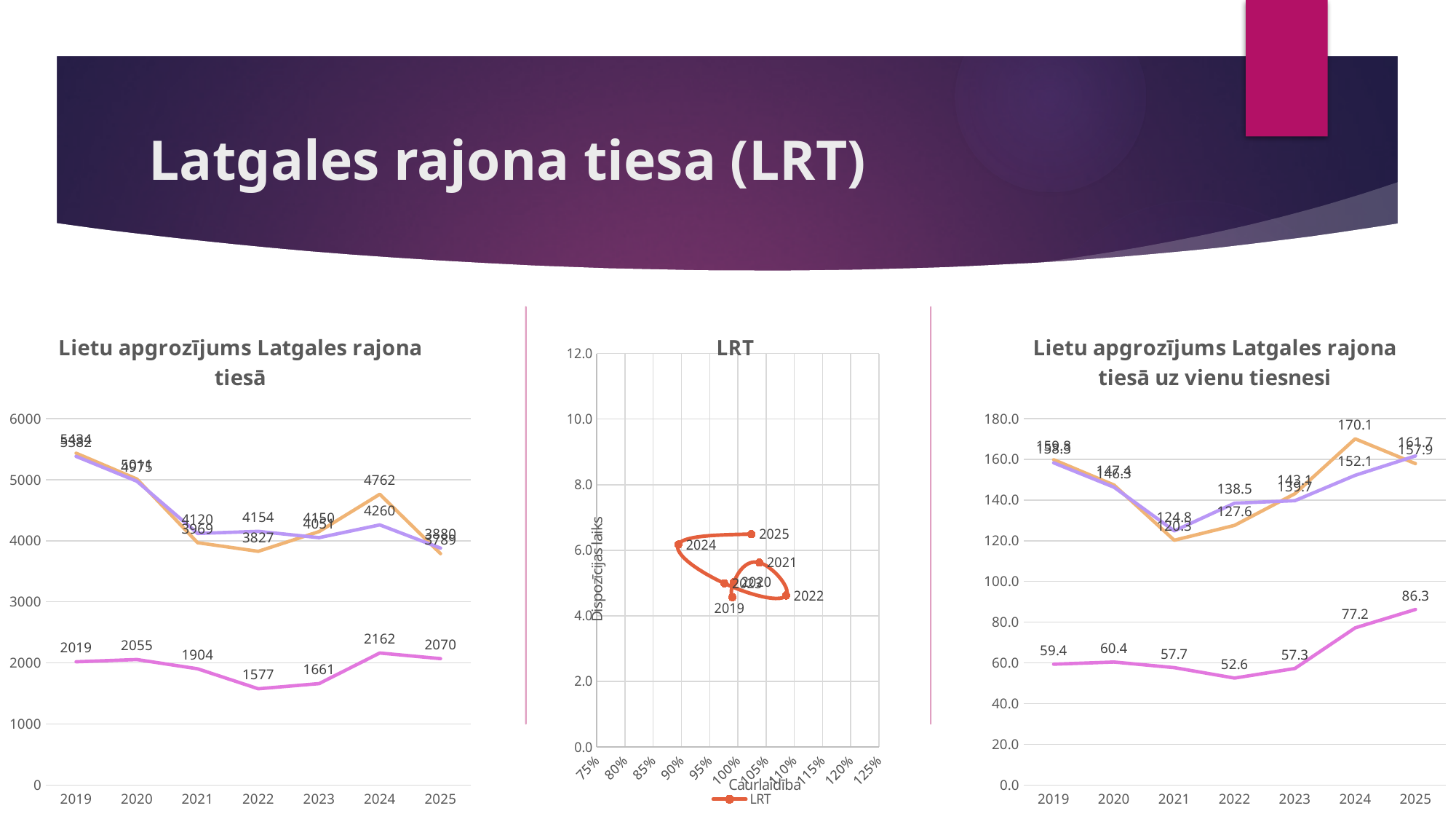
In the chart 'Lietu apgrozījums Latgales rajona tiesā uz vienu tiesnesi', what is the value of the pink (lowest) line in 2025? 86.3 In the chart 'Lietu apgrozījums Latgales rajona tiesā', in which year does the pink (lowest) line reach its lowest value? 2022 In the chart 'Lietu apgrozījums Latgales rajona tiesā uz vienu tiesnesi', does the pink (lowest) line rise or fall from 2023 to 2025? rise In the chart 'Lietu apgrozījums Latgales rajona tiesā', what is the value of the pink (lowest) line in 2022? 1577 How many series does the legend of the middle chart 'LRT' list? 1 What kind of chart is the middle chart titled 'LRT'? scatter chart In the middle chart 'LRT', is the Dispozīcijas laiks value for the 2025 point greater or less than 6.0? greater What is the x-axis title of the middle chart 'LRT'? Caurlaidība How many years are shown on the x axis of the chart 'Lietu apgrozījums Latgales rajona tiesā'? 7 In the chart 'Lietu apgrozījums Latgales rajona tiesā', in which year does the pink (lowest) line reach its highest value? 2024 In the chart 'Lietu apgrozījums Latgales rajona tiesā uz vienu tiesnesi', what is the difference between the pink line's 2025 value and its 2024 value? 9.1 In the chart 'Lietu apgrozījums Latgales rajona tiesā', what is the difference between the pink line's 2024 value and its 2022 value? 585